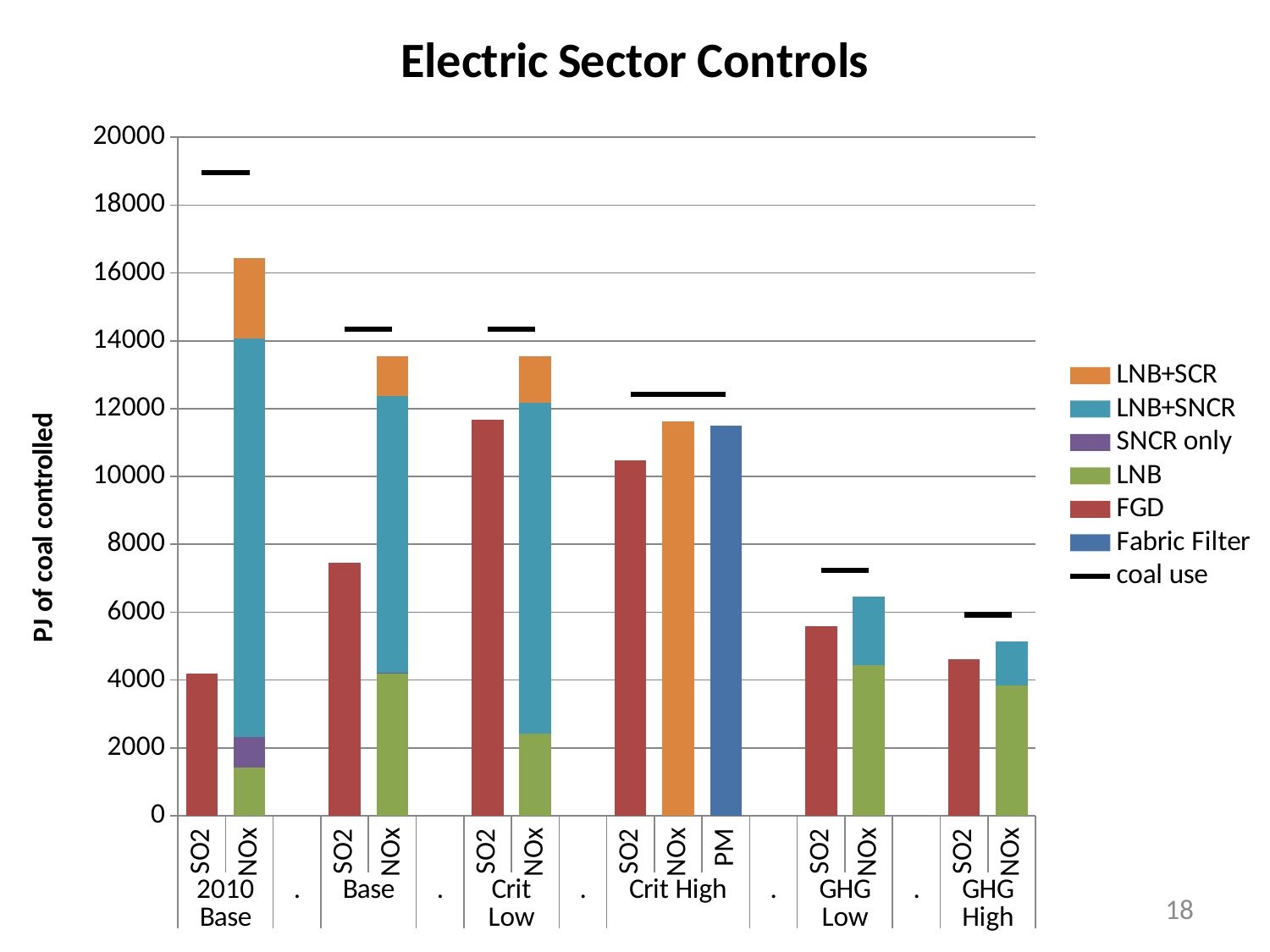
What kind of chart is shown on the slide? Stacked bar chart Is the SO2 bar for the Crit Low scenario greater or less than 10000? greater Is the PM bar for the Crit High scenario greater or less than 10000? greater What is the label on the vertical axis? PJ of coal controlled What is the title of the chart? Electric Sector Controls Which scenario has the tallest NOx bar? 2010 Base Is the SO2 bar for the Base scenario greater or less than 6000? greater How many entries does the legend list? 7 How many scenario groups are shown along the x axis? 6 Which scenario has the lowest coal use marker? GHG High Which is larger, the SO2 bar for Crit Low or the SO2 bar for Crit High? Crit Low